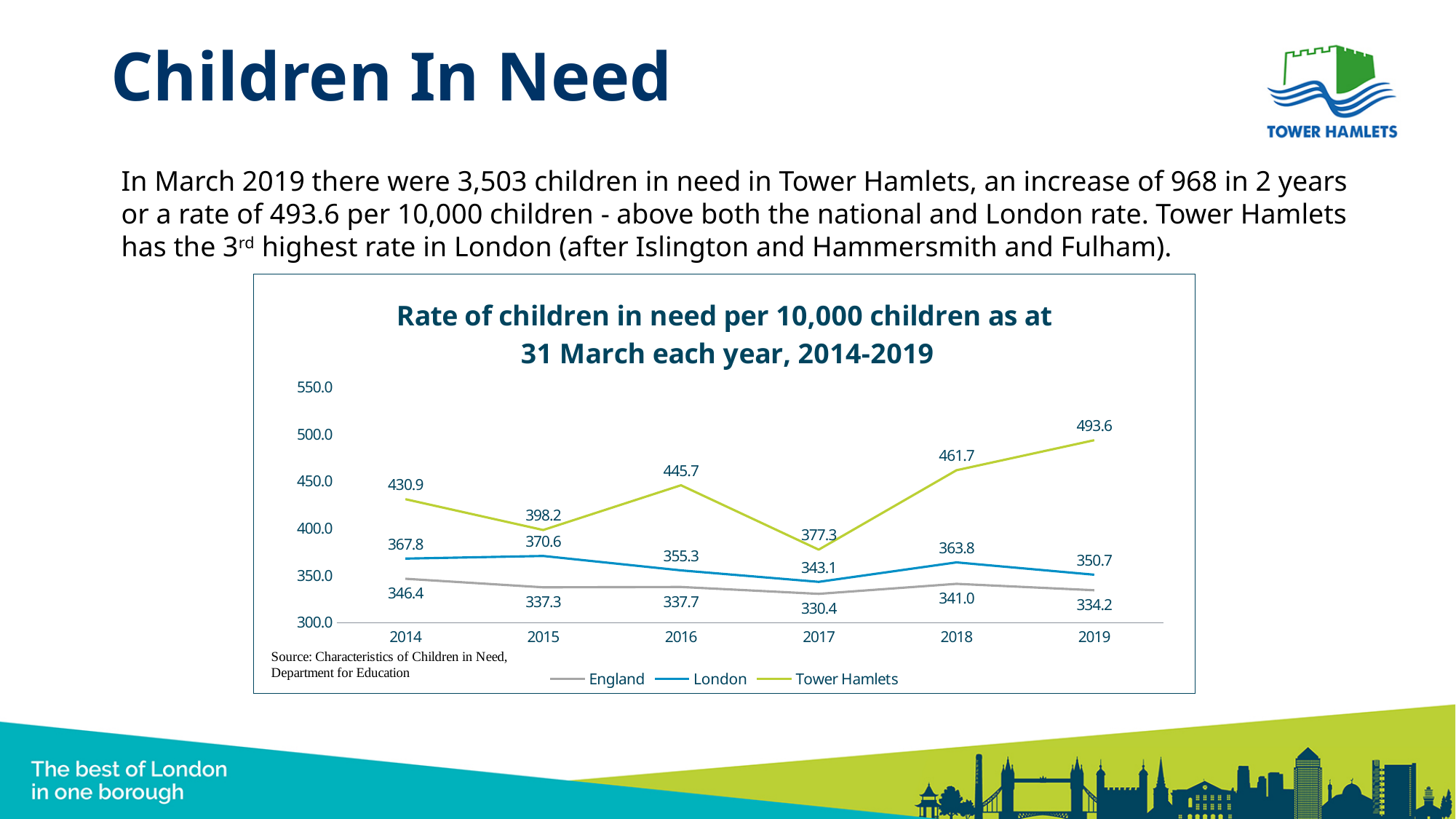
Which had the higher rate of children in need in 2015, London or England? London How many series does the chart's legend list? 3 What was the rate of children in need per 10,000 children for London in 2017? 343.1 In which year was the London rate of children in need lowest? 2017 Did the Tower Hamlets rate of children in need rise or fall between 2017 and 2019? Rise How many years are plotted on the x axis of the chart? 6 What is the difference between the Tower Hamlets rate and the London rate in 2019? 142.9 What kind of chart is used to show the rate of children in need? Line chart What was the rate of children in need per 10,000 children for Tower Hamlets in 2016? 445.7 What was the rate of children in need per 10,000 children for England in 2018? 341.0 In which year was the Tower Hamlets rate of children in need highest? 2019 In which year was the Tower Hamlets rate of children in need lowest? 2017